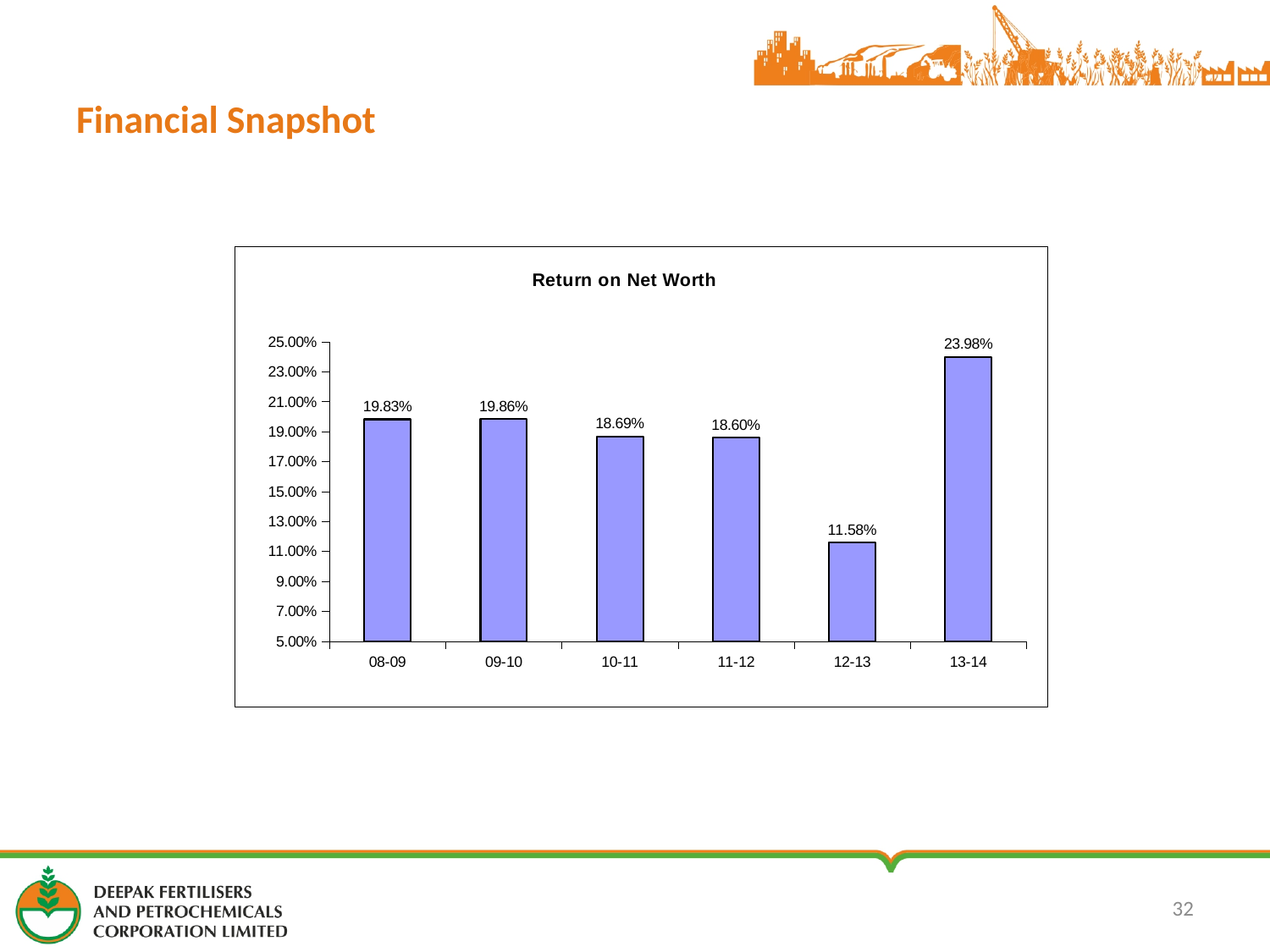
How many years are shown on the Return on Net Worth chart? 6 What is the title of the chart? Return on Net Worth What kind of chart is used to show Return on Net Worth? bar chart What is the Return on Net Worth for 10-11? 18.69% What is the difference in Return on Net Worth between 08-09 and 11-12? 1.23% Which year has the lowest Return on Net Worth? 12-13 What is the difference in Return on Net Worth between 13-14 and 12-13? 12.40% What is the Return on Net Worth for 12-13? 11.58% What is the Return on Net Worth for 13-14? 23.98% Which year has the highest Return on Net Worth? 13-14 Is the Return on Net Worth for 12-13 greater or less than 13.00%? less Which is larger, the Return on Net Worth for 11-12 or for 12-13? 11-12